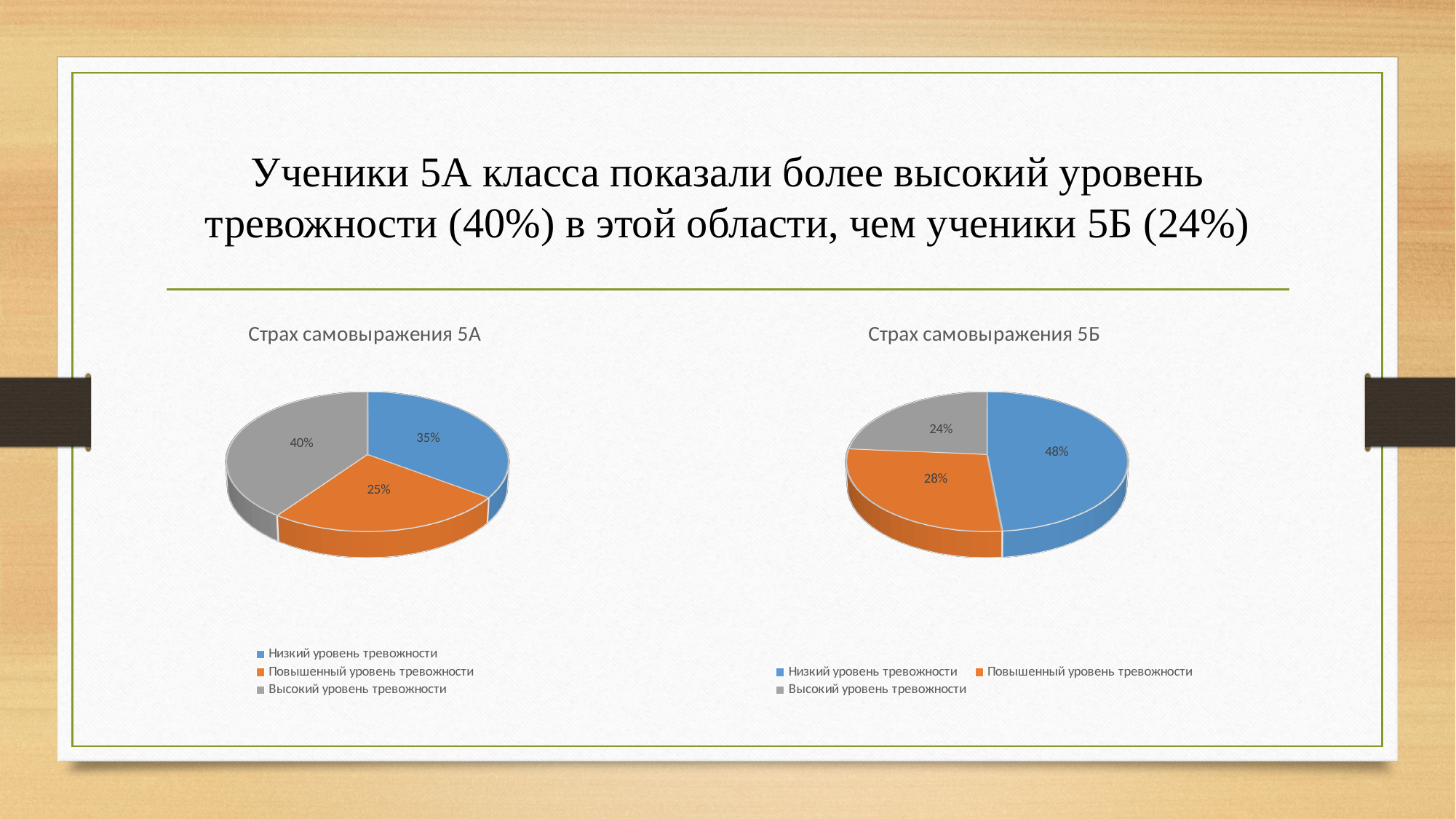
In the chart titled "Страх самовыражения 5Б", what is the value for "Низкий уровень тревожности"? 48% In the chart titled "Страх самовыражения 5А", which category has the largest slice? Высокий уровень тревожности How many categories does the legend of the "Страх самовыражения 5А" chart list? 3 In the chart titled "Страх самовыражения 5Б", what share of the pie is "Высокий уровень тревожности"? 24% In the chart titled "Страх самовыражения 5А", what is the value for "Повышенный уровень тревожности"? 25% What type of chart is "Страх самовыражения 5Б"? Pie chart Which is larger: "Повышенный уровень тревожности" in the "Страх самовыражения 5А" chart or in the "Страх самовыражения 5Б" chart? Страх самовыражения 5Б In the chart titled "Страх самовыражения 5А", what is the value for "Низкий уровень тревожности"? 35% In the chart titled "Страх самовыражения 5А", what share of the pie is "Высокий уровень тревожности"? 40% In the chart titled "Страх самовыражения 5Б", which category has the largest slice? Низкий уровень тревожности In the chart titled "Страх самовыражения 5А", which category has the smallest slice? Повышенный уровень тревожности What is the difference between the "Высокий уровень тревожности" share in the "Страх самовыражения 5А" chart and in the "Страх самовыражения 5Б" chart? 16%